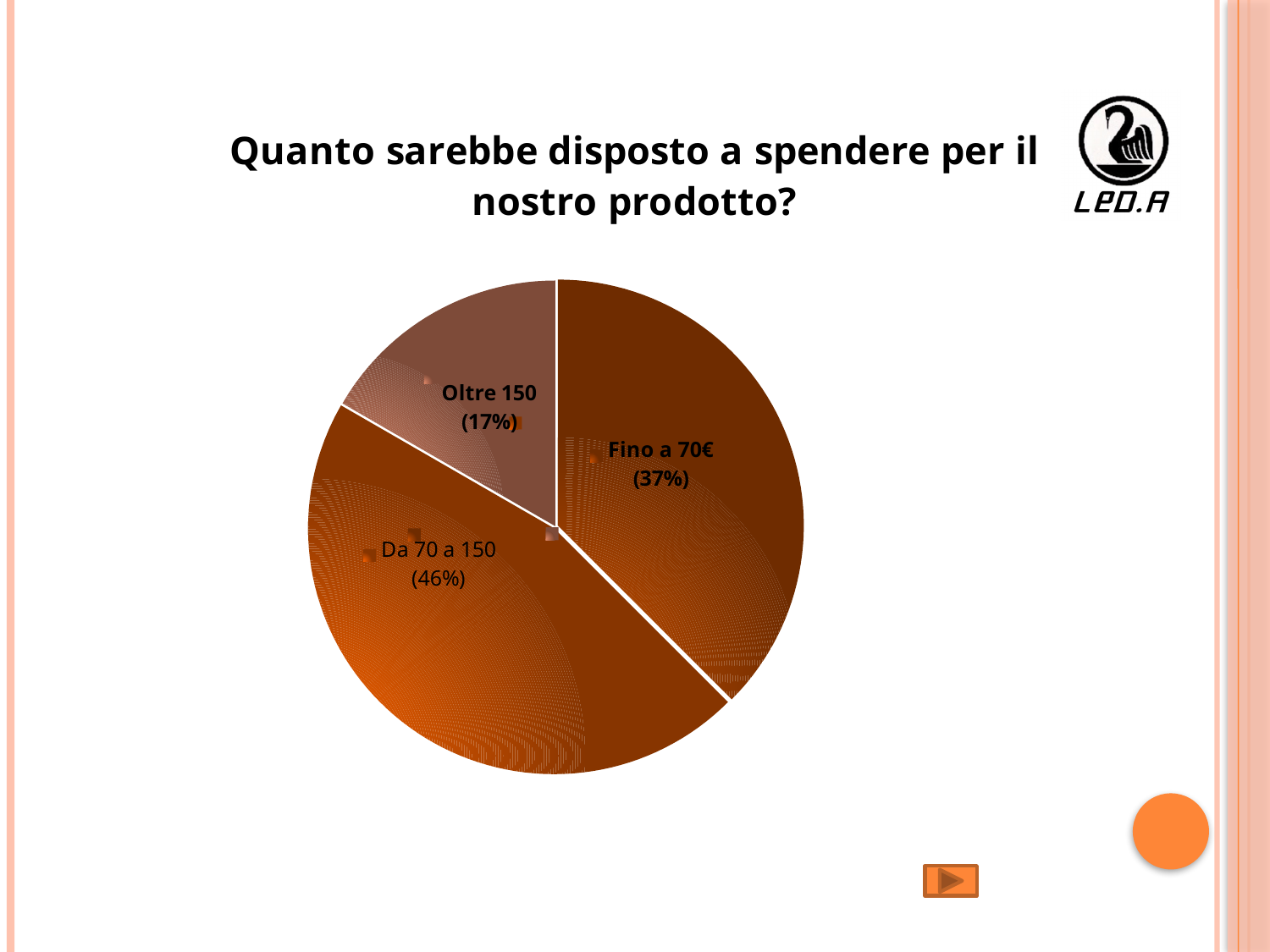
What is the difference in percentage points between "Fino a 70€" and "Oltre 150"? 20 What is the title of the slide containing the pie chart? Quanto sarebbe disposto a spendere per il nostro prodotto? What kind of chart is shown on the slide? pie chart How many slices does the pie chart have? 3 Which is larger, the share for "Fino a 70€" or the share for "Oltre 150"? Fino a 70€ What share of the pie is labelled "Fino a 70€"? 37% Which category has the largest slice of the pie? Da 70 a 150 What is the difference in percentage points between "Da 70 a 150" and "Fino a 70€"? 9 Which category has the smallest slice of the pie? Oltre 150 What is the combined share of "Fino a 70€" and "Da 70 a 150"? 83% What share of the pie is labelled "Oltre 150"? 17% What share of the pie is labelled "Da 70 a 150"? 46%